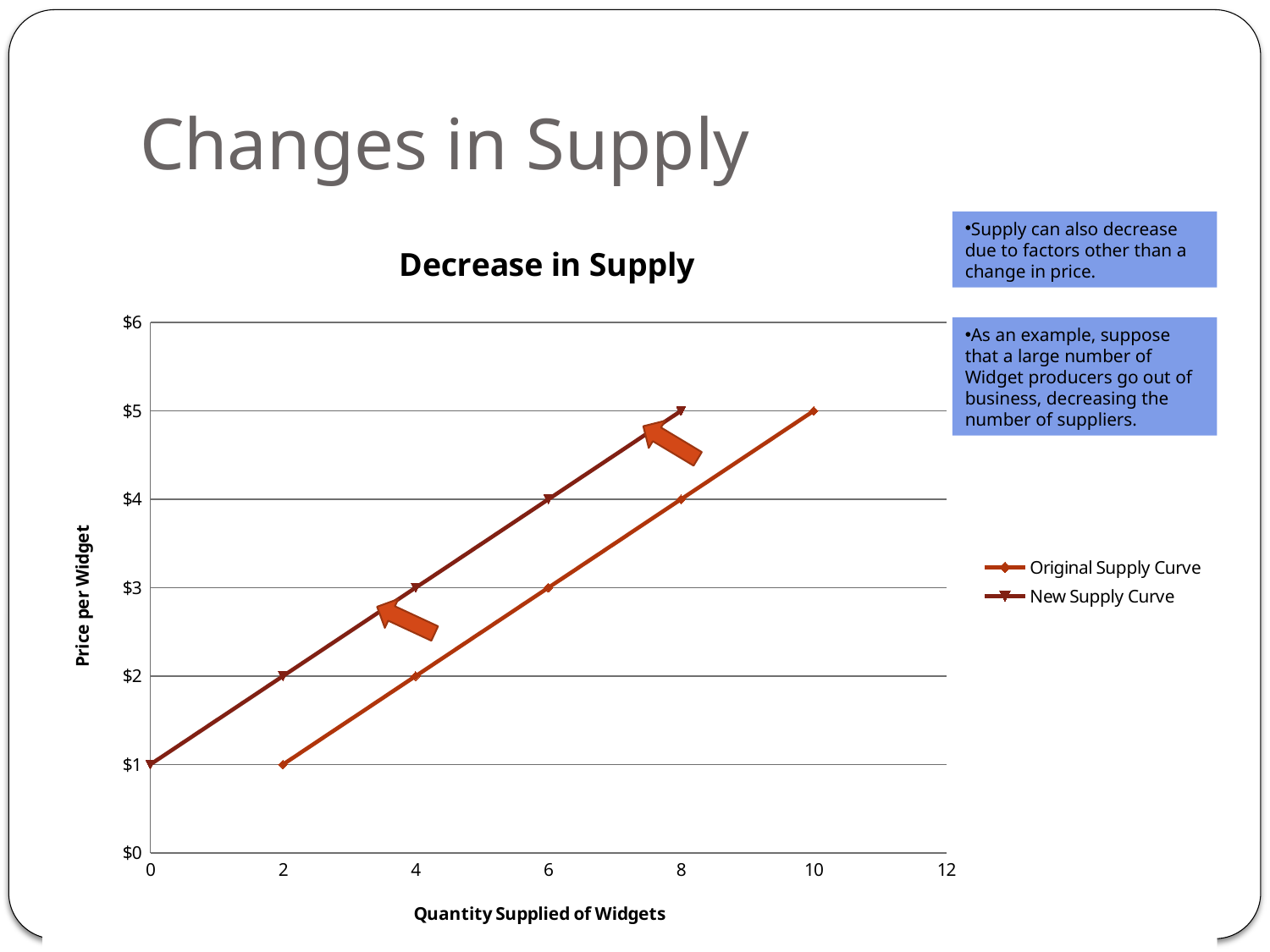
How many series does the legend list? 2 On the New Supply Curve, what is the price per widget when the quantity supplied is 6? $4 On the Original Supply Curve, what quantity is supplied at a price of $5? 10 How many data points are plotted on the Original Supply Curve? 5 What is the label of the y axis? Price per Widget What type of chart is shown? line chart On the New Supply Curve, what quantity is supplied at a price of $5? 8 On the Original Supply Curve, what is the price per widget when the quantity supplied is 6? $3 Does the price on the Original Supply Curve rise or fall as quantity supplied increases? rise At a price of $3, what is the difference in quantity supplied between the Original Supply Curve and the New Supply Curve? 2 At a quantity of 4, which series shows the higher price: Original Supply Curve or New Supply Curve? New Supply Curve What is the title of the chart? Decrease in Supply